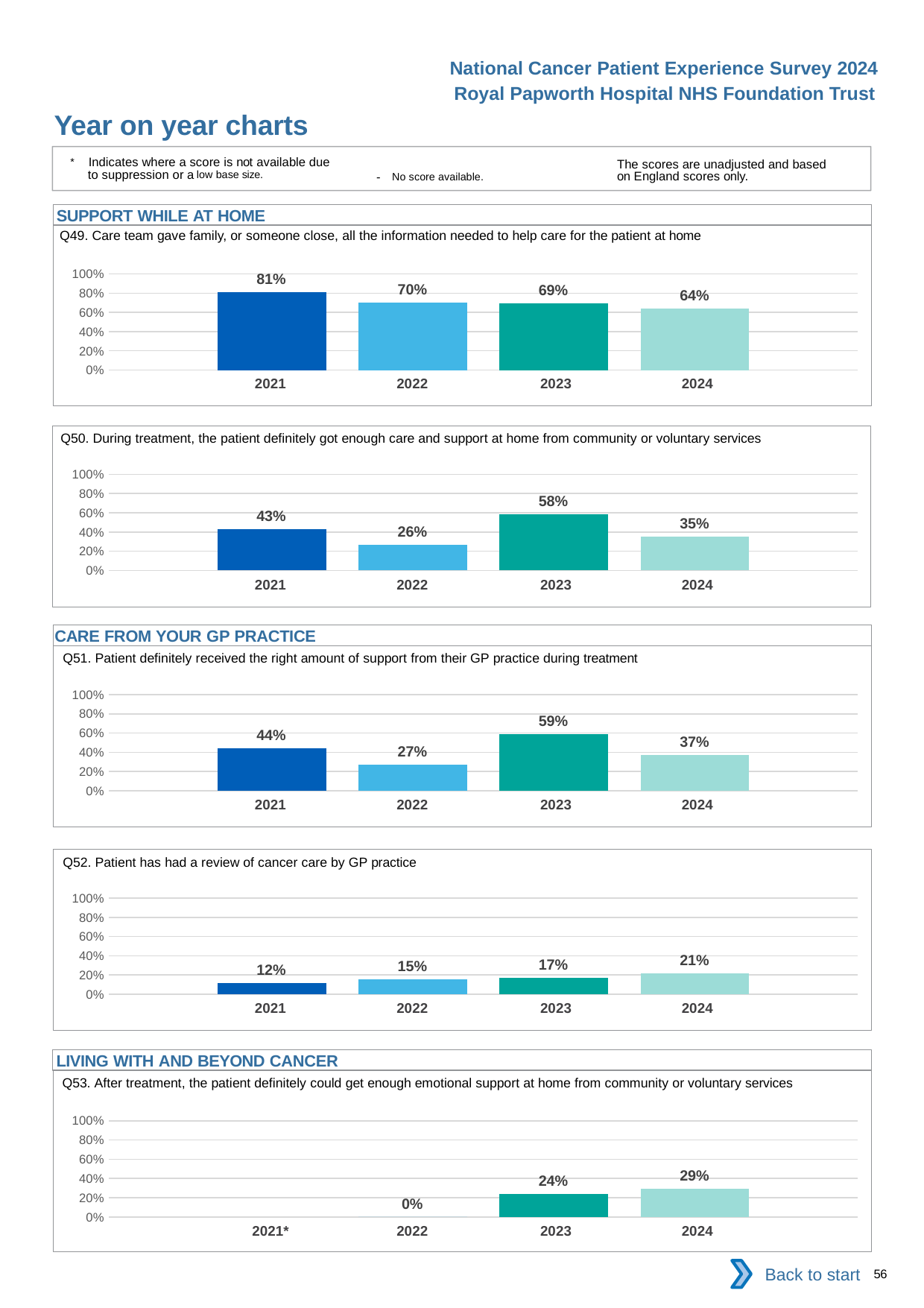
In the Q50 chart, what is the difference between the 2023 and 2022 values? 32% What kind of chart is used for Q52? bar chart In the Q52 chart, what is the difference between the 2024 and 2021 values? 9% In the Q49 chart, which year has the lowest value? 2024 In the Q49 chart, what is the value for 2021? 81% How many year categories are shown on the x axis of the Q53 chart? 4 In the Q51 chart, what is the value for 2024? 37% In the Q50 chart, which year has the highest value? 2023 In the Q52 chart, do the values rise or fall from 2021 to 2024? rise In the Q49 chart, do the values rise or fall from 2021 to 2024? fall In the Q51 chart, which is larger, the value for 2021 or the value for 2022? 2021 In the Q53 chart, what is the value for 2022? 0%